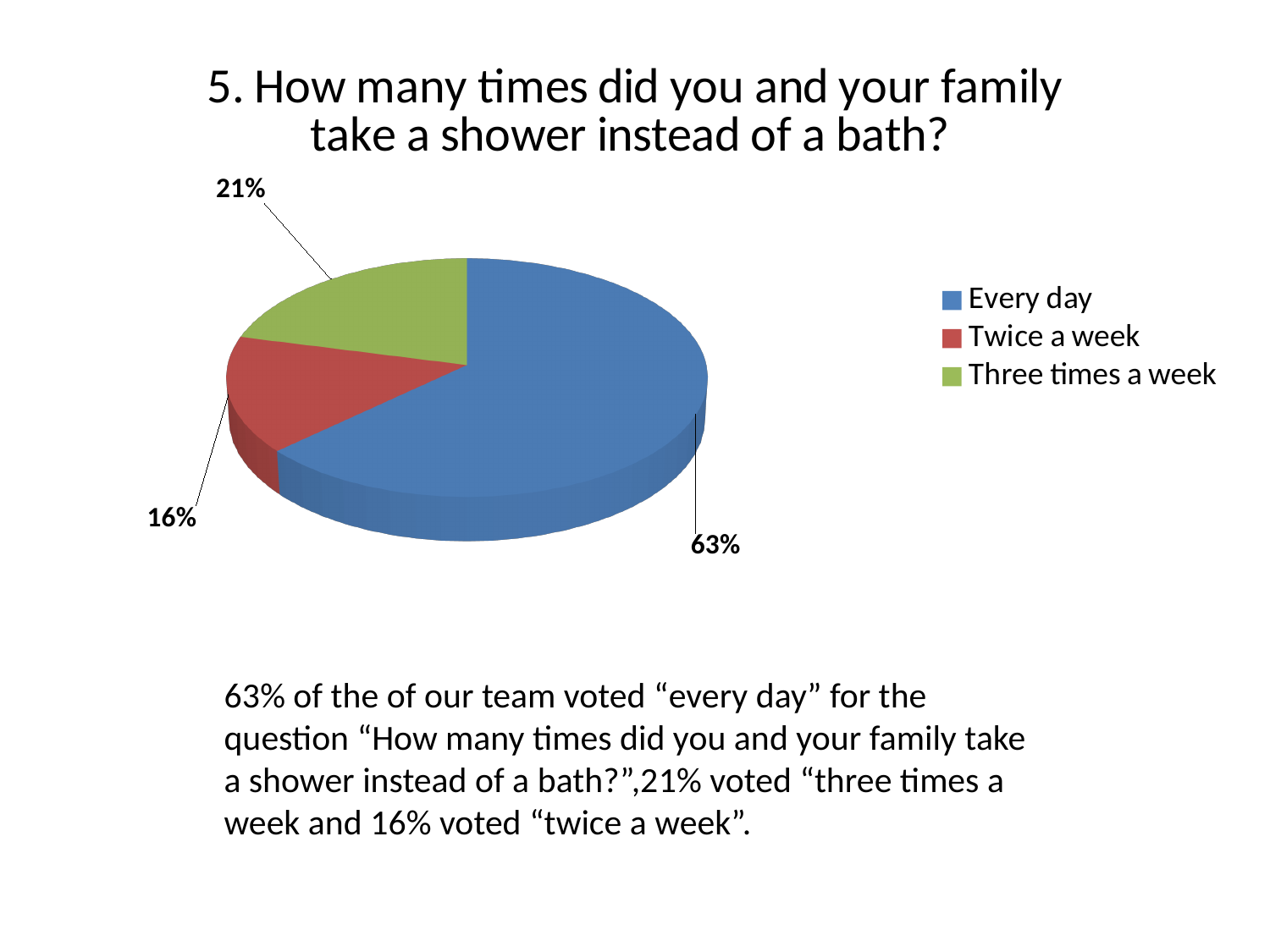
How many categories are shown in the pie chart? 3 What kind of chart is shown on the slide? Pie chart What percentage of the pie chart is for "Every day"? 63% Which category has the largest slice of the pie chart? Every day Which category is shown in green in the legend? Three times a week What is the difference in percentage points between "Every day" and "Three times a week"? 42 Which category has the smallest slice of the pie chart? Twice a week What percentage of the pie chart is for "Three times a week"? 21% Which is larger: the slice for "Twice a week" or the slice for "Three times a week"? Three times a week What is the difference in percentage points between "Three times a week" and "Twice a week"? 5 What colour is the slice for "Every day"? Blue What percentage of the pie chart is for "Twice a week"? 16%